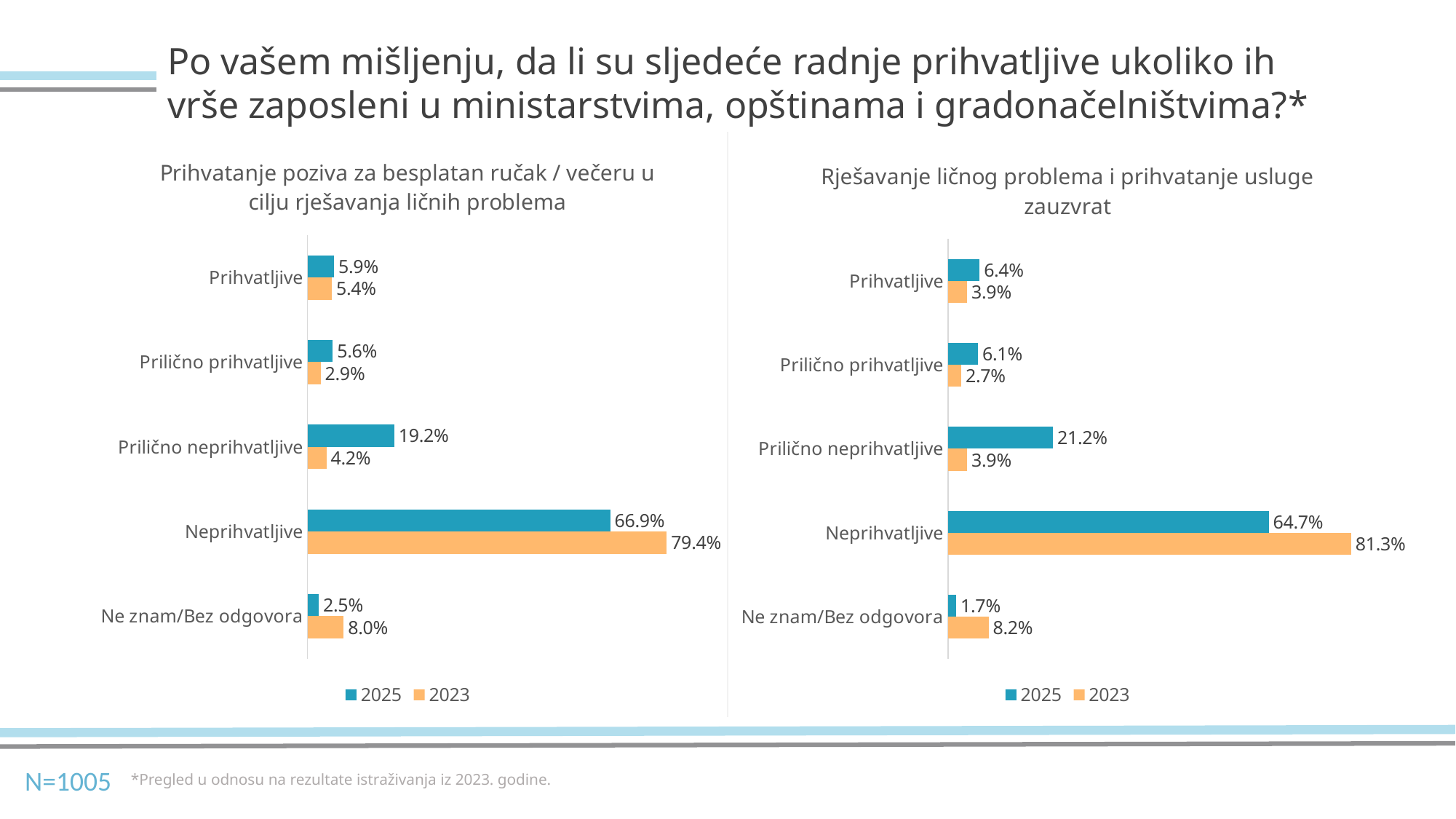
In the right chart (Rješavanje ličnog problema i prihvatanje usluge zauzvrat), which is larger for Prihvatljive: the 2025 value or the 2023 value? 2025 In the right chart (Rješavanje ličnog problema i prihvatanje usluge zauzvrat), what is the 2023 value for Neprihvatljive? 81.3% In the left chart (Prihvatanje poziva za besplatan ručak / večeru u cilju rješavanja ličnih problema), what is the 2023 value for Ne znam/Bez odgovora? 8.0% In the right chart (Rješavanje ličnog problema i prihvatanje usluge zauzvrat), what is the difference between the 2025 and 2023 values for Prilično neprihvatljive? 17.3% How many series does the legend of the right chart (Rješavanje ličnog problema i prihvatanje usluge zauzvrat) list? 2 In the right chart (Rješavanje ličnog problema i prihvatanje usluge zauzvrat), what is the 2025 value for Prilično neprihvatljive? 21.2% How many categories does the left chart (Prihvatanje poziva za besplatan ručak / večeru u cilju rješavanja ličnih problema) show? 5 In the left chart (Prihvatanje poziva za besplatan ručak / večeru u cilju rješavanja ličnih problema), which category has the highest 2025 value? Neprihvatljive In the right chart (Rješavanje ličnog problema i prihvatanje usluge zauzvrat), which category has the lowest 2025 value? Ne znam/Bez odgovora In the left chart (Prihvatanje poziva za besplatan ručak / večeru u cilju rješavanja ličnih problema), what is the 2025 value for Neprihvatljive? 66.9% What type of chart is the left chart (Prihvatanje poziva za besplatan ručak / večeru u cilju rješavanja ličnih problema)? Bar chart In the left chart (Prihvatanje poziva za besplatan ručak / večeru u cilju rješavanja ličnih problema), what is the difference between the 2023 and 2025 values for Neprihvatljive? 12.5%